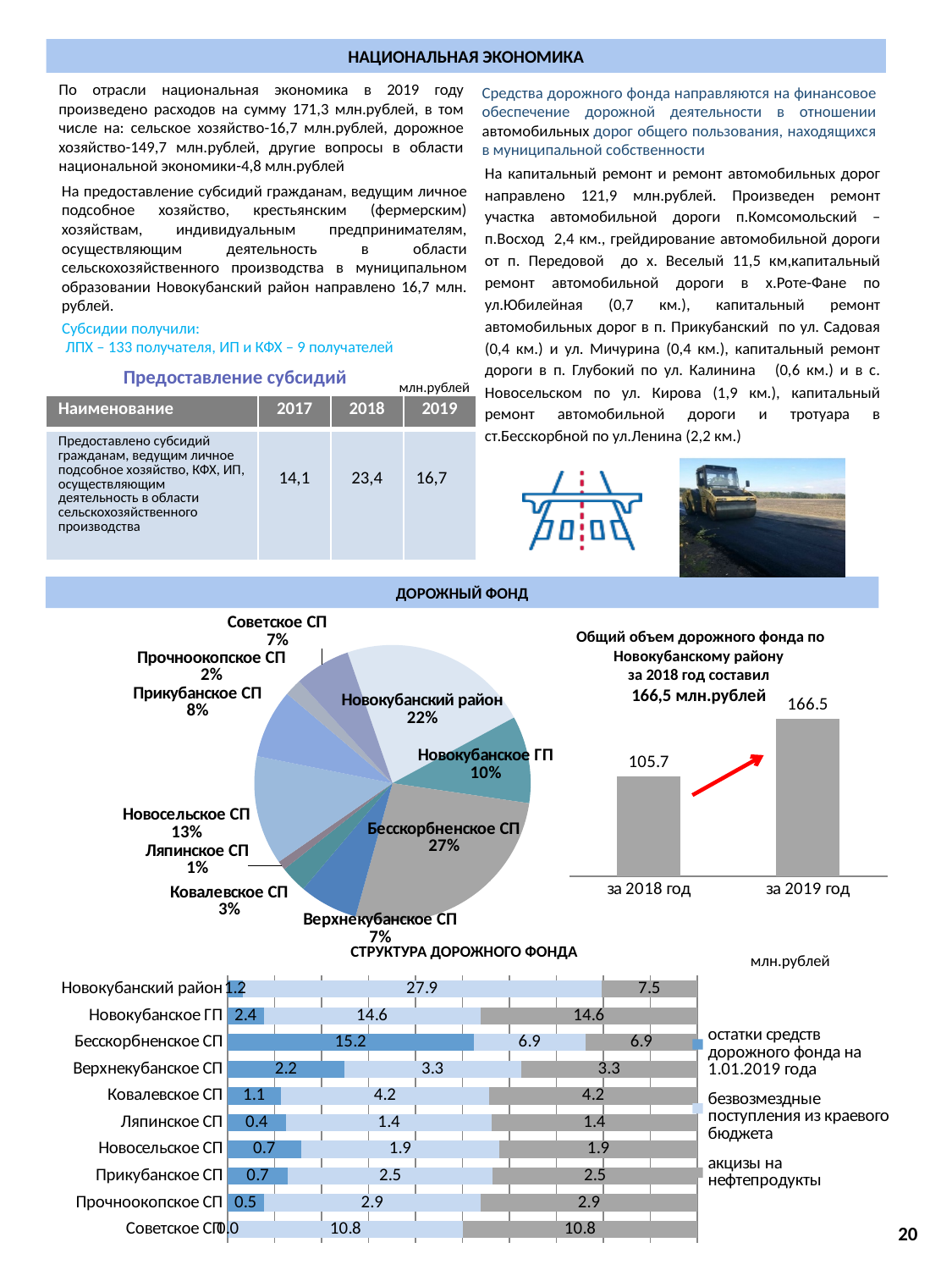
In the pie chart, what is the share for Новосельское СП? 13% In the chart 'СТРУКТУРА ДОРОЖНОГО ФОНДА', what is the total of the stacked bar for Советское СП? 21.6 What type of chart is 'СТРУКТУРА ДОРОЖНОГО ФОНДА'? stacked bar chart In the bar chart titled 'Общий объем дорожного фонда по Новокубанскому району', what is the difference between the 2019 and 2018 values? 60.8 In the bar chart titled 'Общий объем дорожного фонда по Новокубанскому району', do the values rise or fall from 2018 to 2019? rise How many slices does the pie chart have? 10 In the pie chart, which category has the largest share? Бесскорбненское СП How many series does the legend of the chart 'СТРУКТУРА ДОРОЖНОГО ФОНДА' list? 3 In the pie chart, which is larger: the share of Новокубанский район or the share of Новокубанское ГП? Новокубанский район In the pie chart, what share of the road fund does Бесскорбненское СП have? 27% In the bar chart titled 'Общий объем дорожного фонда по Новокубанскому району', what is the value for 'за 2019 год'? 166.5 In the pie chart, which category has the smallest share? Ляпинское СП